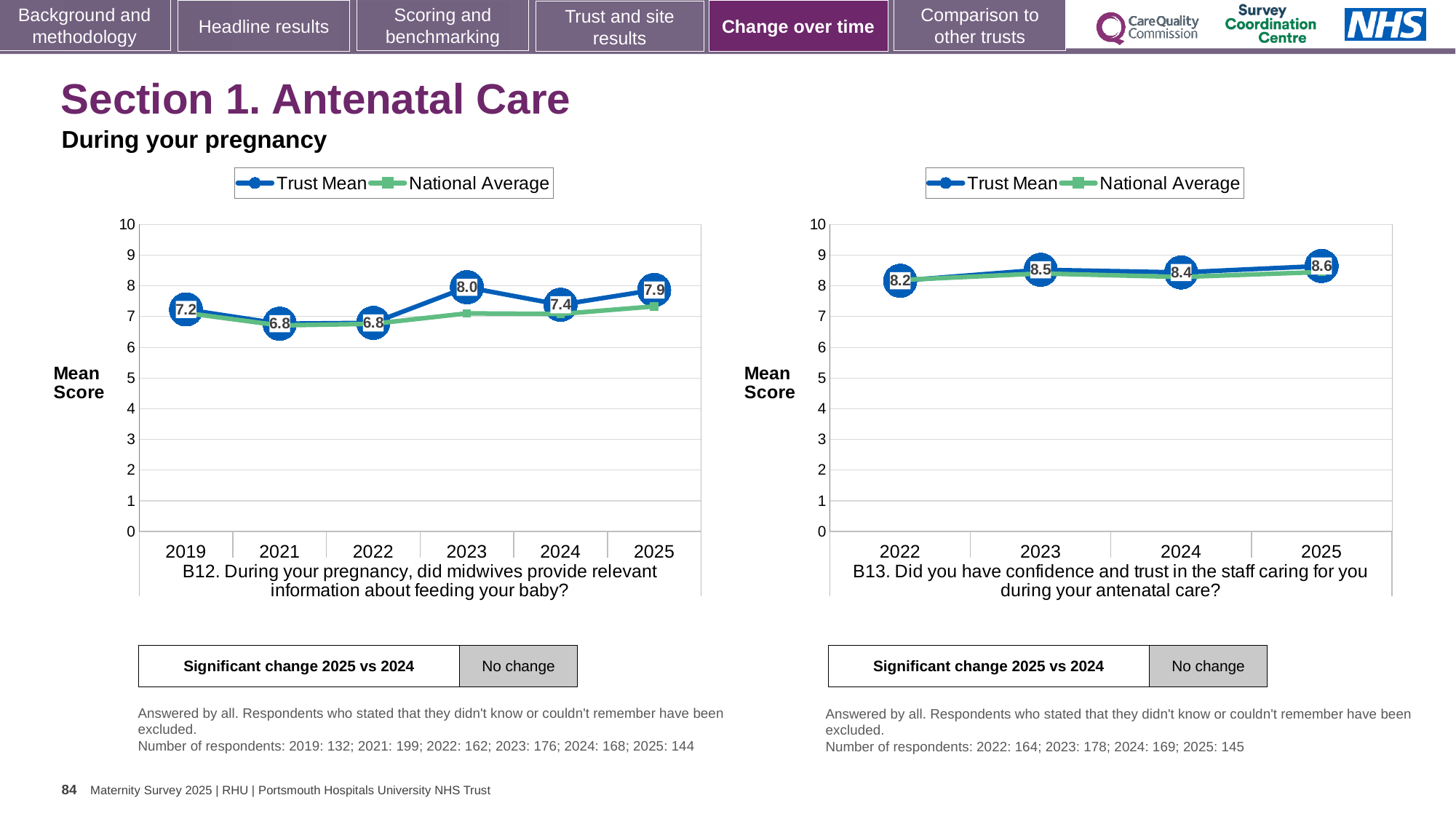
In the B13 chart (right), what is the Trust Mean score for 2025? 8.6 In the B12 chart (left), is the National Average for 2025 greater or less than 8? less In the B12 chart (left), which year has the highest Trust Mean score? 2023 In the B13 chart (right), which is larger, the Trust Mean score for 2023 or for 2024? 2023 In the B12 chart (left), what is the Trust Mean score for 2023? 8.0 In the B13 chart (right), which year has the lowest Trust Mean score? 2022 In the B13 chart (right), what is the Trust Mean score for 2022? 8.2 What type of chart is the B13 chart (right)? Line chart In the B12 chart (left), what is the Trust Mean score for 2019? 7.2 How many series does the legend of the B12 chart (left) list? 2 How many years are shown on the x axis of the B13 chart (right)? 4 In the B12 chart (left), what is the difference between the Trust Mean scores for 2025 and 2024? 0.5